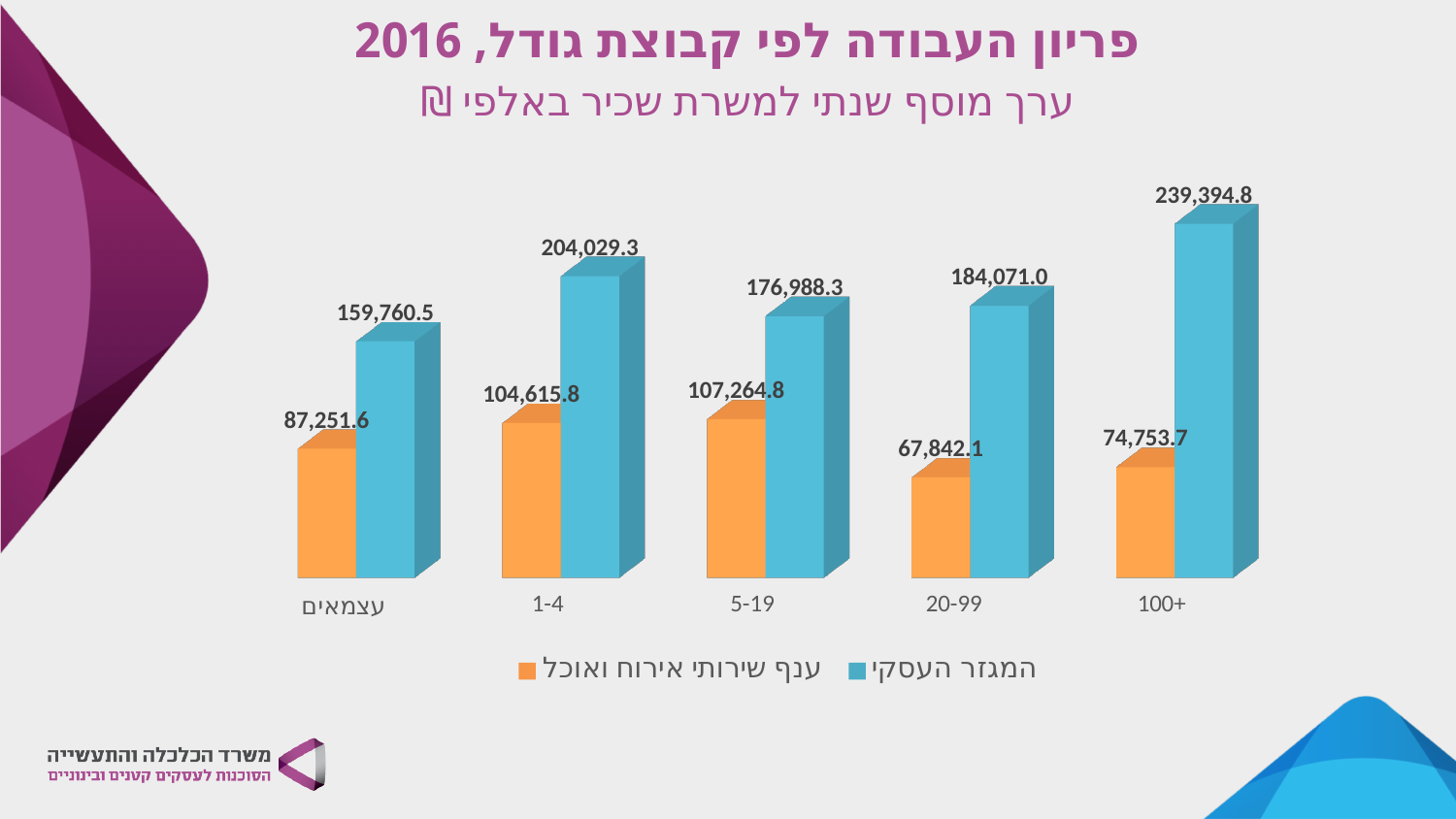
Which category has the lowest value for the ענף שירותי אירוח ואוכל series? 20-99 How many categories are shown on the x axis? 5 What kind of chart is shown on the slide? Bar chart Which category has the highest value for the ענף שירותי אירוח ואוכל series? 5-19 What is the value for the המגזר העסקי series in the 100+ category? 239,394.8 Which is larger: the המגזר העסקי value for 1-4 or for 20-99? 1-4 What is the value for the ענף שירותי אירוח ואוכל series in the 20-99 category? 67,842.1 What is the value for the המגזר העסקי series in the עצמאים category? 159,760.5 Which category has the highest value for the המגזר העסקי series? 100+ What is the value for the ענף שירותי אירוח ואוכל series in the 1-4 category? 104,615.8 What is the difference between the המגזר העסקי and ענף שירותי אירוח ואוכל values in the 5-19 category? 69,723.5 How many series does the legend list? 2